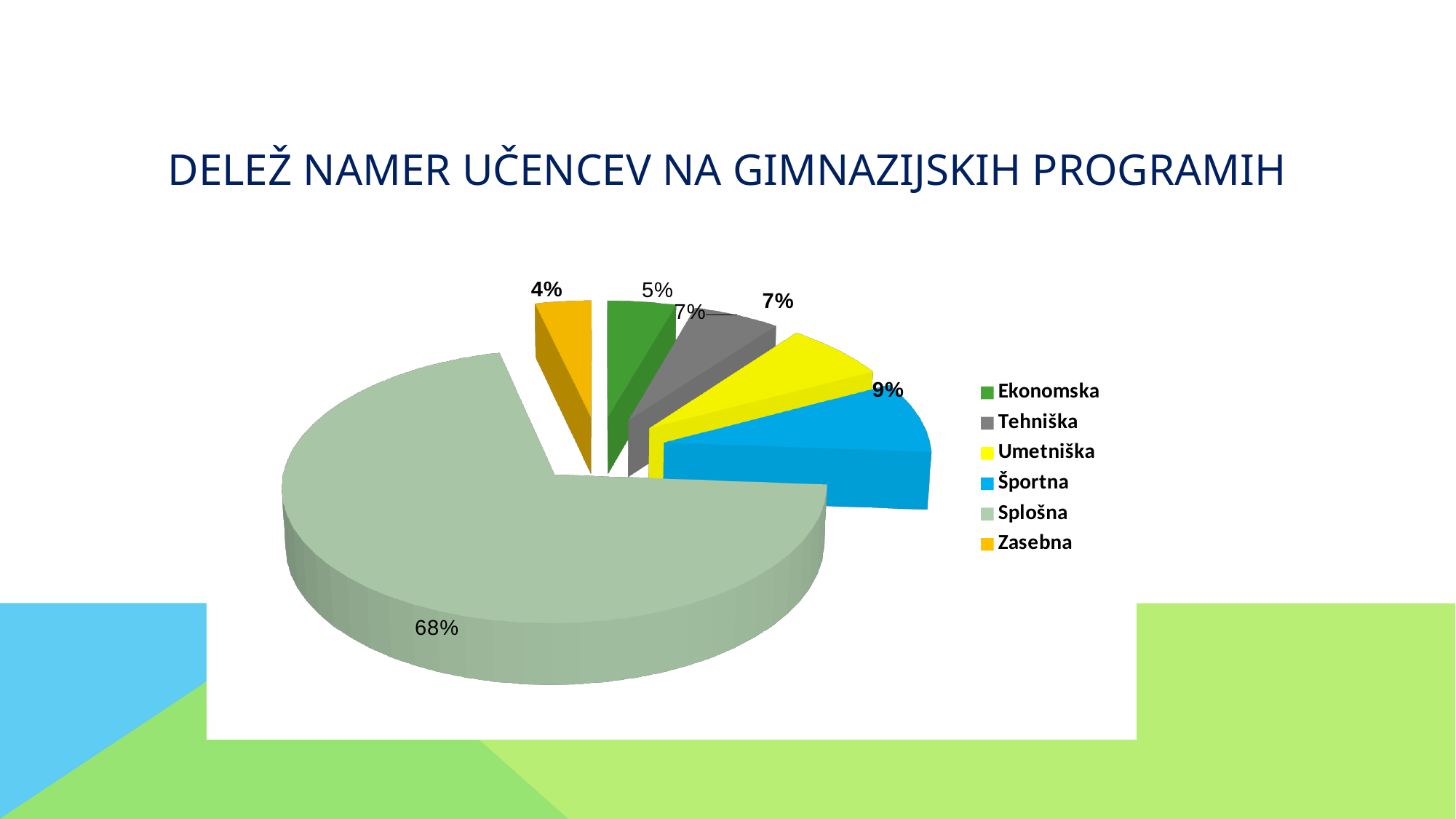
What share of the pie does Ekonomska have? 5% Which has a larger share, Športna or Ekonomska? Športna What share of the pie does Športna have? 9% What share of the pie does Splošna have? 68% Which category has the largest share of the pie? Splošna What kind of chart is shown on the slide? pie chart Which category has the smallest share of the pie? Zasebna What is the difference between the shares of Splošna and Športna? 59% What share of the pie does Zasebna have? 4% How many categories does the legend list? 6 What is the title of the chart? DELEŽ NAMER UČENCEV NA GIMNAZIJSKIH PROGRAMIH What share of the pie does Umetniška have? 7%